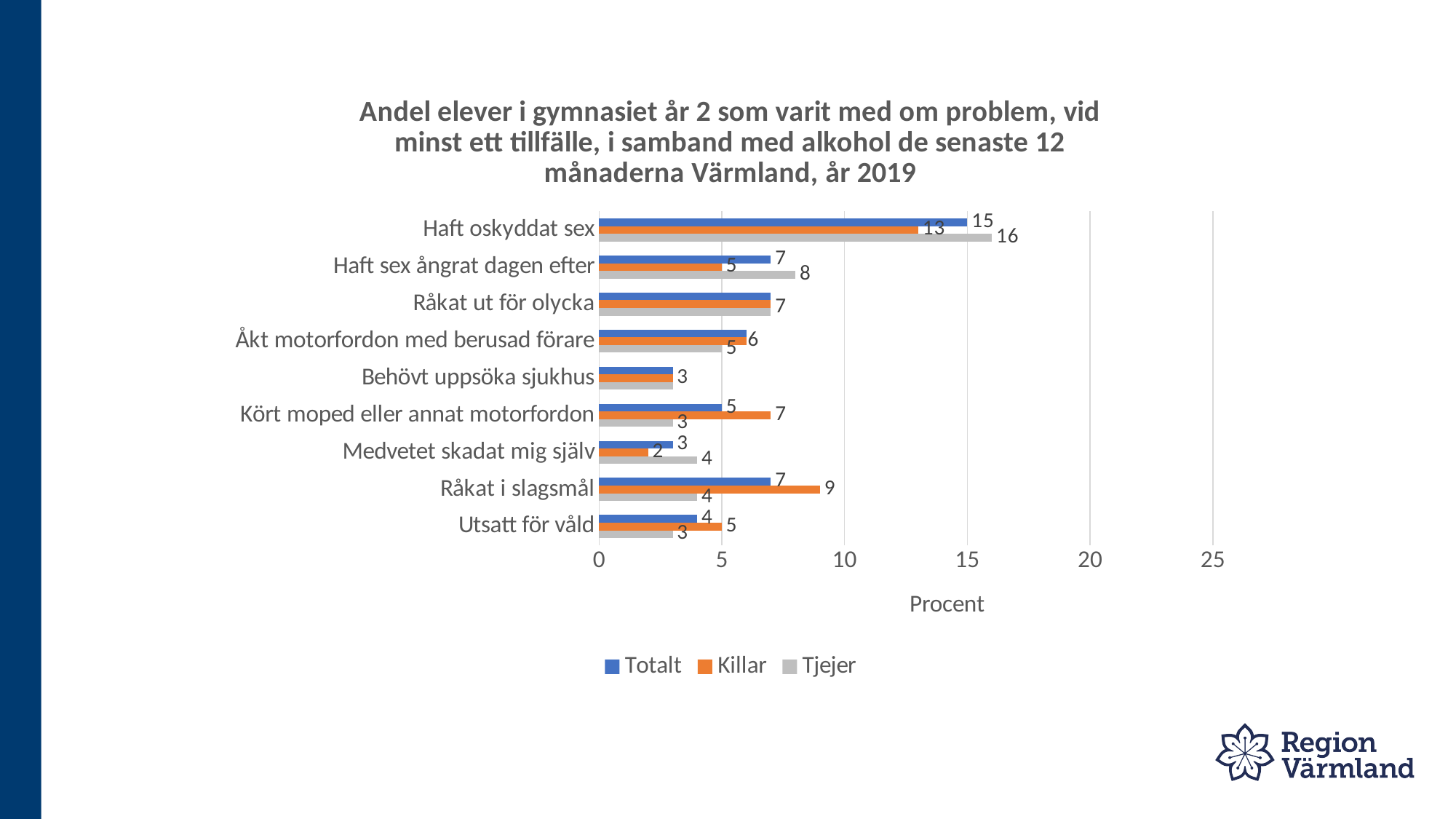
What is the difference between the Tjejer and Killar values for 'Haft oskyddat sex'? 3 What is the value for Totalt in the category 'Kört moped eller annat motorfordon'? 5 How many series does the legend list? 3 What is the value for Killar in the category 'Råkat i slagsmål'? 9 What is the value for Killar in the category 'Medvetet skadat mig själv'? 2 Which category has the highest Totalt value? Haft oskyddat sex What is the value for Tjejer in the category 'Haft oskyddat sex'? 16 How many categories are shown on the chart? 9 What kind of chart is shown on the slide? Bar chart Which category has the lowest Killar value? Medvetet skadat mig själv Is the Totalt value for 'Haft oskyddat sex' greater or less than 10? greater For 'Råkat i slagsmål', which is larger: Killar or Tjejer? Killar